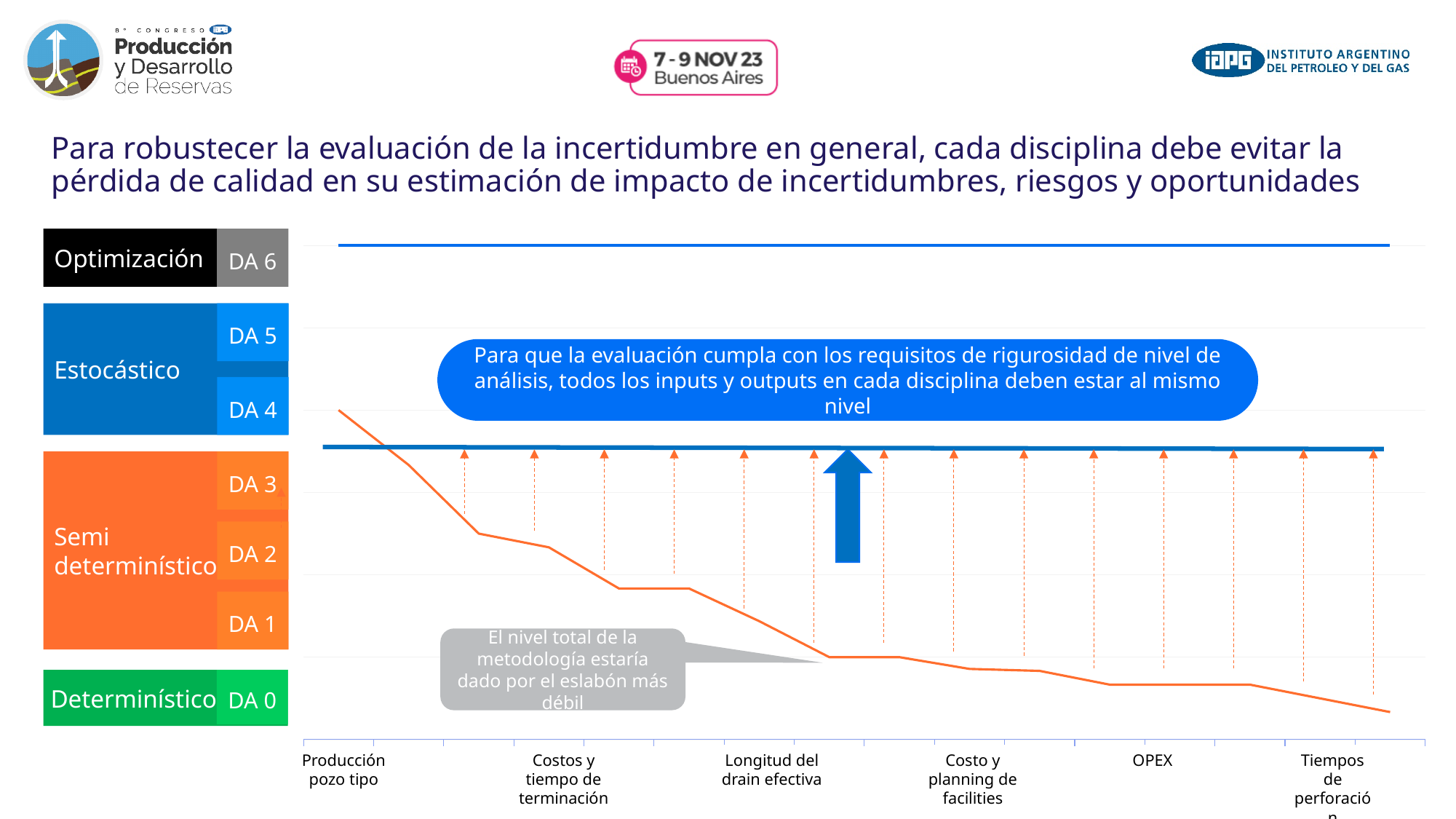
Does the orange line rise or fall as you move from left to right along the x axis? fall What kind of chart is shown on the slide? line chart On the orange line, which is larger: the value at Producción pozo tipo or the value at OPEX? Producción pozo tipo On the orange line, which is larger: the value at Longitud del drain efectiva or the value at Costo y planning de facilities? Longitud del drain efectiva On the orange line, which is larger: the value at Costos y tiempo de terminación or the value at Tiempos de perforación? Costos y tiempo de terminación Which labeled x-axis category has the highest value on the orange line? Producción pozo tipo What is the label of the first category on the x axis? Producción pozo tipo How many category labels are printed along the x axis of the chart? 6 Which labeled x-axis category has the lowest value on the orange line? Tiempos de perforación What colour is the declining line in the chart? orange